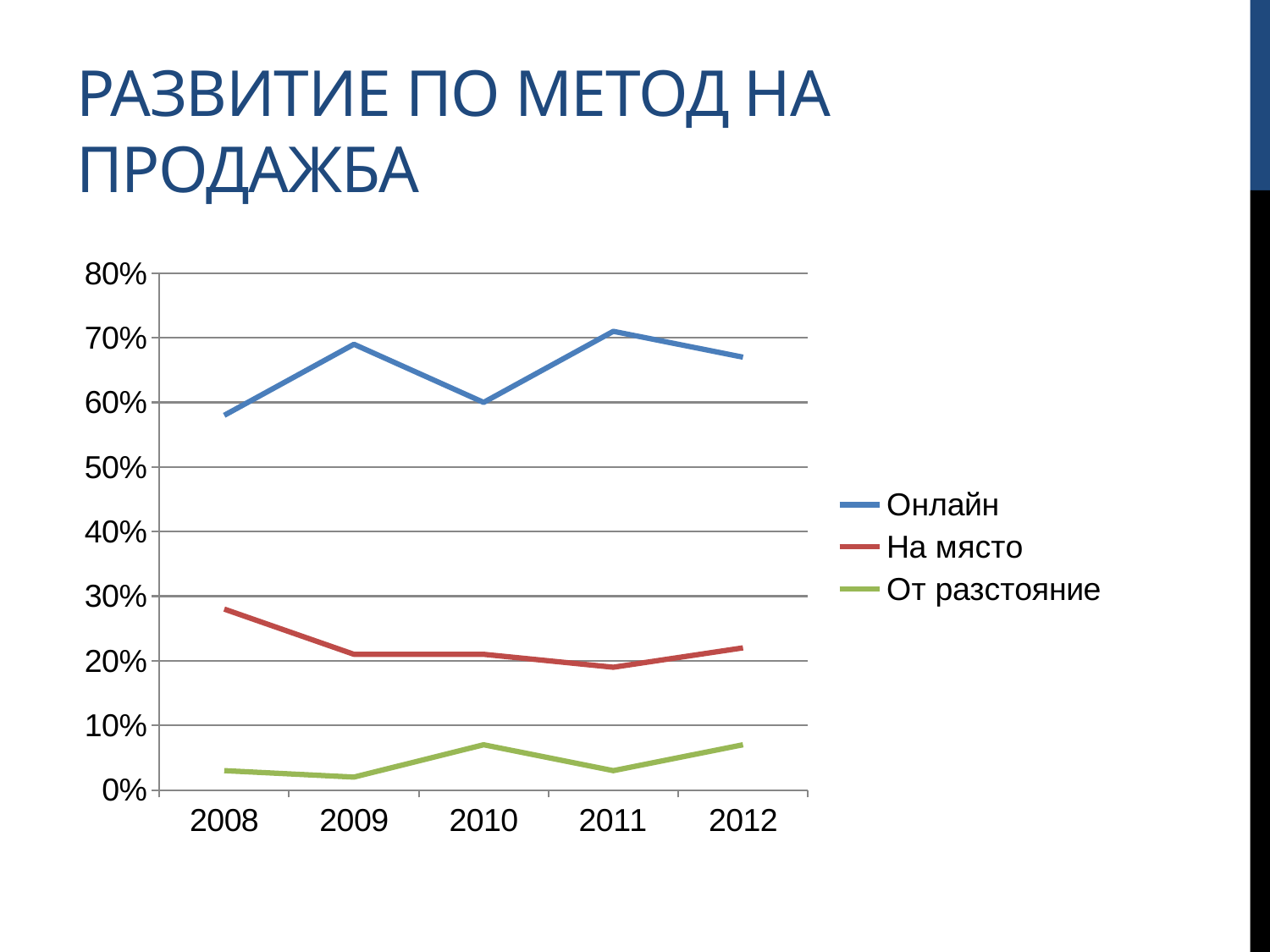
How many series does the legend list? 3 Is the value for От разстояние in 2010 greater or less than 10%? less Is the value for Онлайн in 2011 greater or less than 70%? greater Does the На място series rise or fall from 2008 to 2009? fall What kind of chart is shown on the slide? line chart Which series has the lowest values across all years? От разстояние What is the title of the slide? РАЗВИТИЕ ПО МЕТОД НА ПРОДАЖБА Is the value for На място in 2008 greater or less than 20%? greater How many years are shown on the x axis? 5 Which is larger for На място: the value in 2008 or the value in 2011? 2008 Which series has the highest values across all years? Онлайн